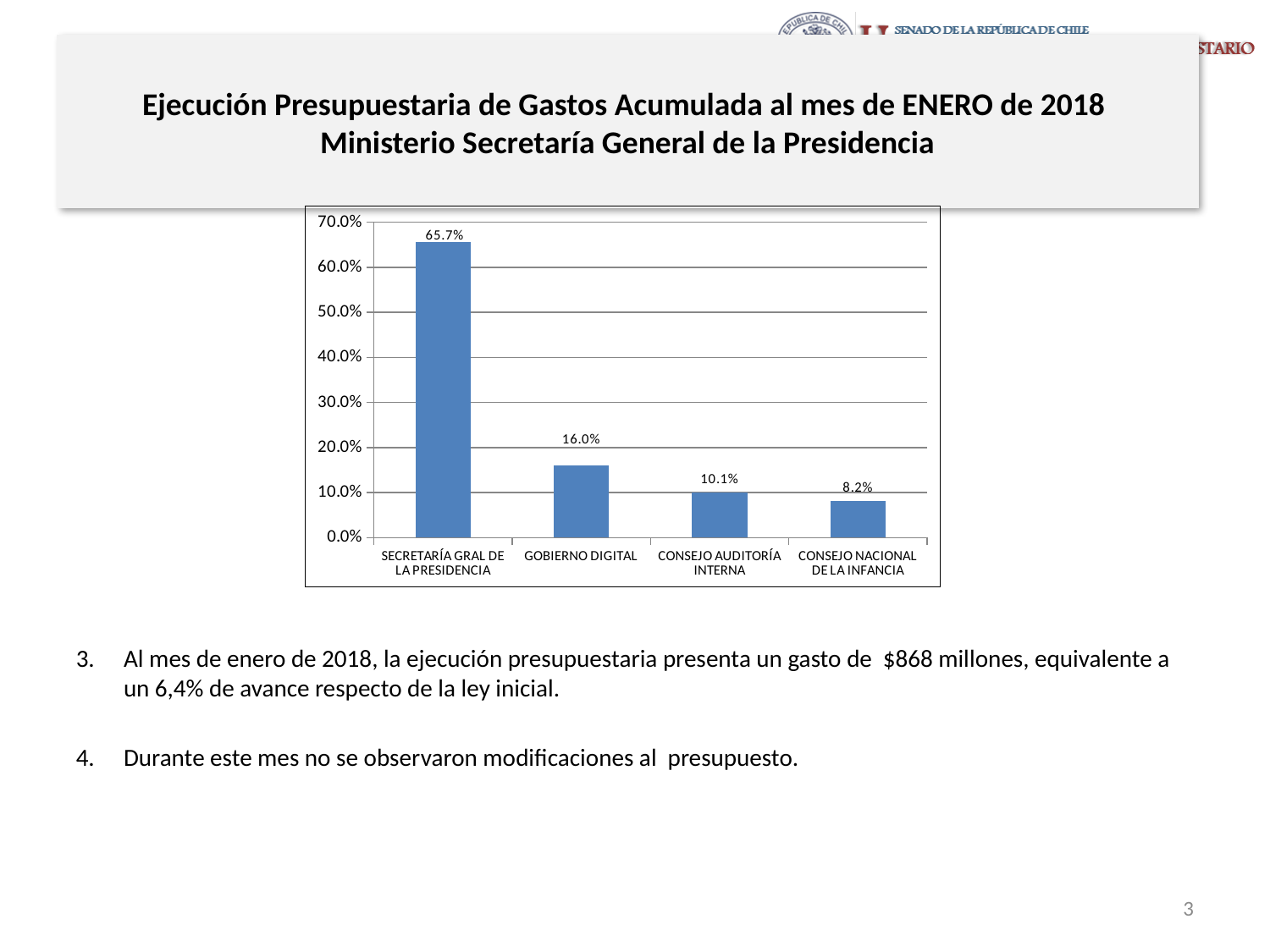
What is the value for CONSEJO NACIONAL DE LA INFANCIA? 8.2% Is the value for GOBIERNO DIGITAL greater or less than 20.0%? less What is the difference between the values for CONSEJO AUDITORÍA INTERNA and CONSEJO NACIONAL DE LA INFANCIA? 1.9% How many categories are shown in the chart? 4 Which category has the lowest value? CONSEJO NACIONAL DE LA INFANCIA Which category has the highest value? SECRETARÍA GRAL DE LA PRESIDENCIA What is the value for GOBIERNO DIGITAL? 16.0% What kind of chart is shown on the slide? bar chart Which is larger, the value for GOBIERNO DIGITAL or the value for CONSEJO AUDITORÍA INTERNA? GOBIERNO DIGITAL What is the value for CONSEJO AUDITORÍA INTERNA? 10.1% What is the value for SECRETARÍA GRAL DE LA PRESIDENCIA? 65.7% What is the difference between the values for SECRETARÍA GRAL DE LA PRESIDENCIA and GOBIERNO DIGITAL? 49.7%